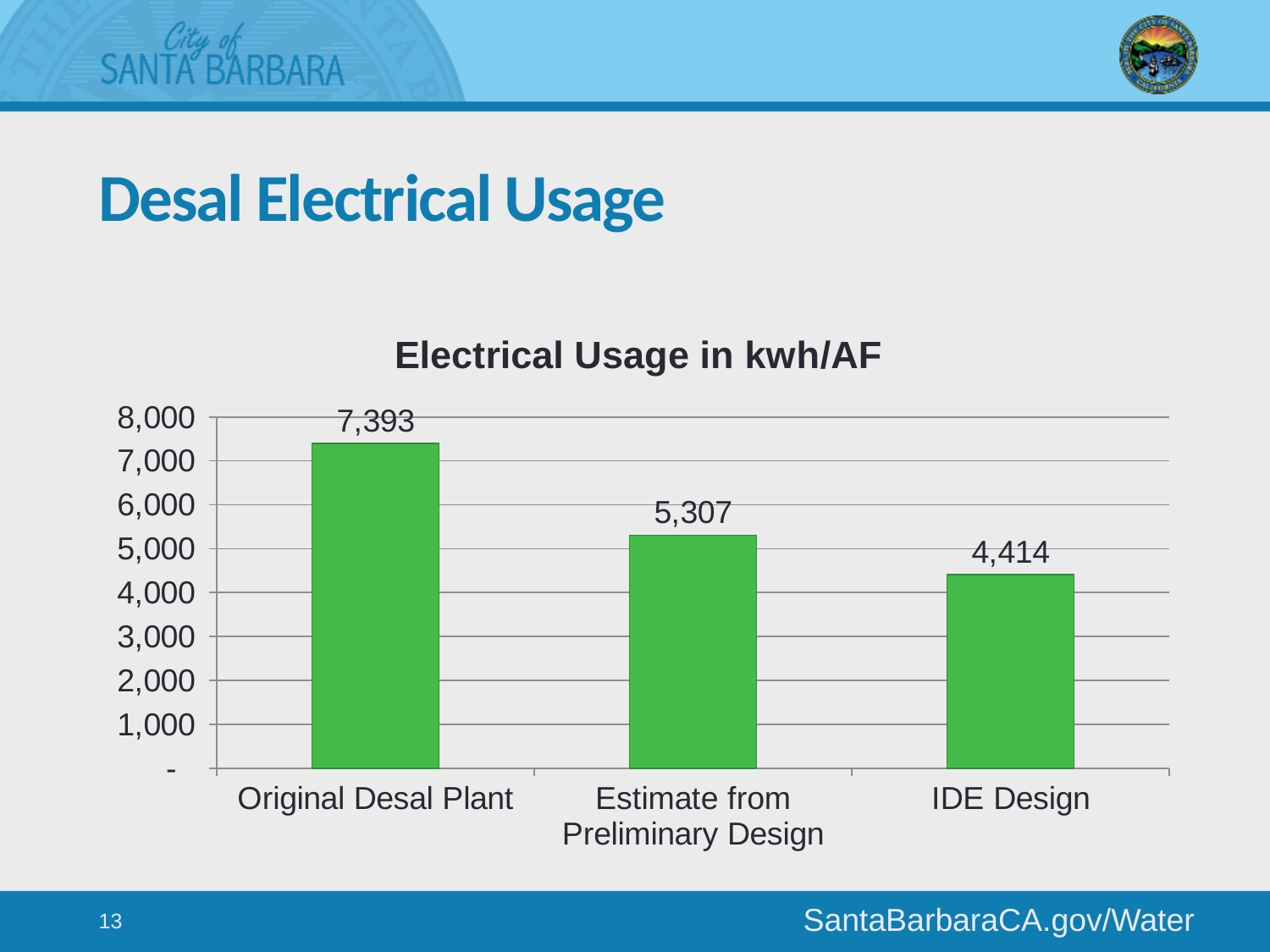
Is the value for the Estimate from Preliminary Design greater or less than 5,000? greater What is the electrical usage value for the Estimate from Preliminary Design? 5,307 Which has a larger electrical usage, the Estimate from Preliminary Design or the IDE Design? Estimate from Preliminary Design What is the title of the chart? Electrical Usage in kwh/AF What is the electrical usage value for the IDE Design? 4,414 What is the electrical usage value for the Original Desal Plant? 7,393 What kind of chart is shown on the slide? Bar chart How many categories are shown in the chart? 3 What is the difference in electrical usage between the Original Desal Plant and the IDE Design? 2,979 Which category has the highest electrical usage? Original Desal Plant What is the difference in electrical usage between the Estimate from Preliminary Design and the IDE Design? 893 Which category has the lowest electrical usage? IDE Design